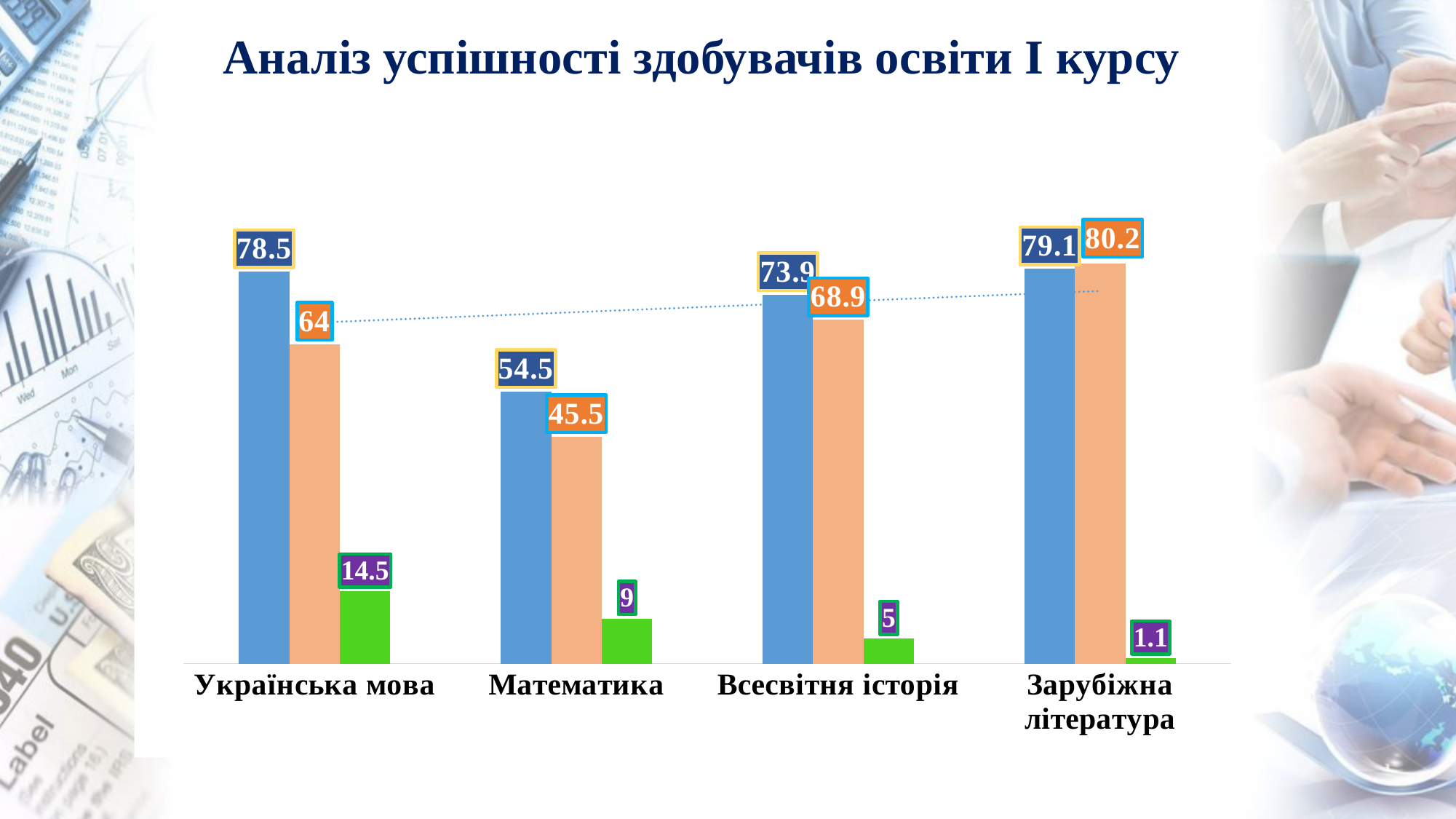
What kind of chart is shown on the slide? bar chart What is the value of the orange bar for Всесвітня історія? 68.9 Which is larger for Зарубіжна література, the blue bar or the orange bar? the orange bar Do the green bar values rise or fall from Українська мова to Зарубіжна література? fall How many categories are shown on the x axis? 4 Which category has the lowest green bar? Зарубіжна література Which category has the highest blue bar? Зарубіжна література What is the difference between the blue and orange bars for Українська мова? 14.5 What is the value of the blue bar for Математика? 54.5 What is the value of the orange bar for Українська мова? 64 What is the value of the green bar for Зарубіжна література? 1.1 Which category has the lowest orange bar? Математика